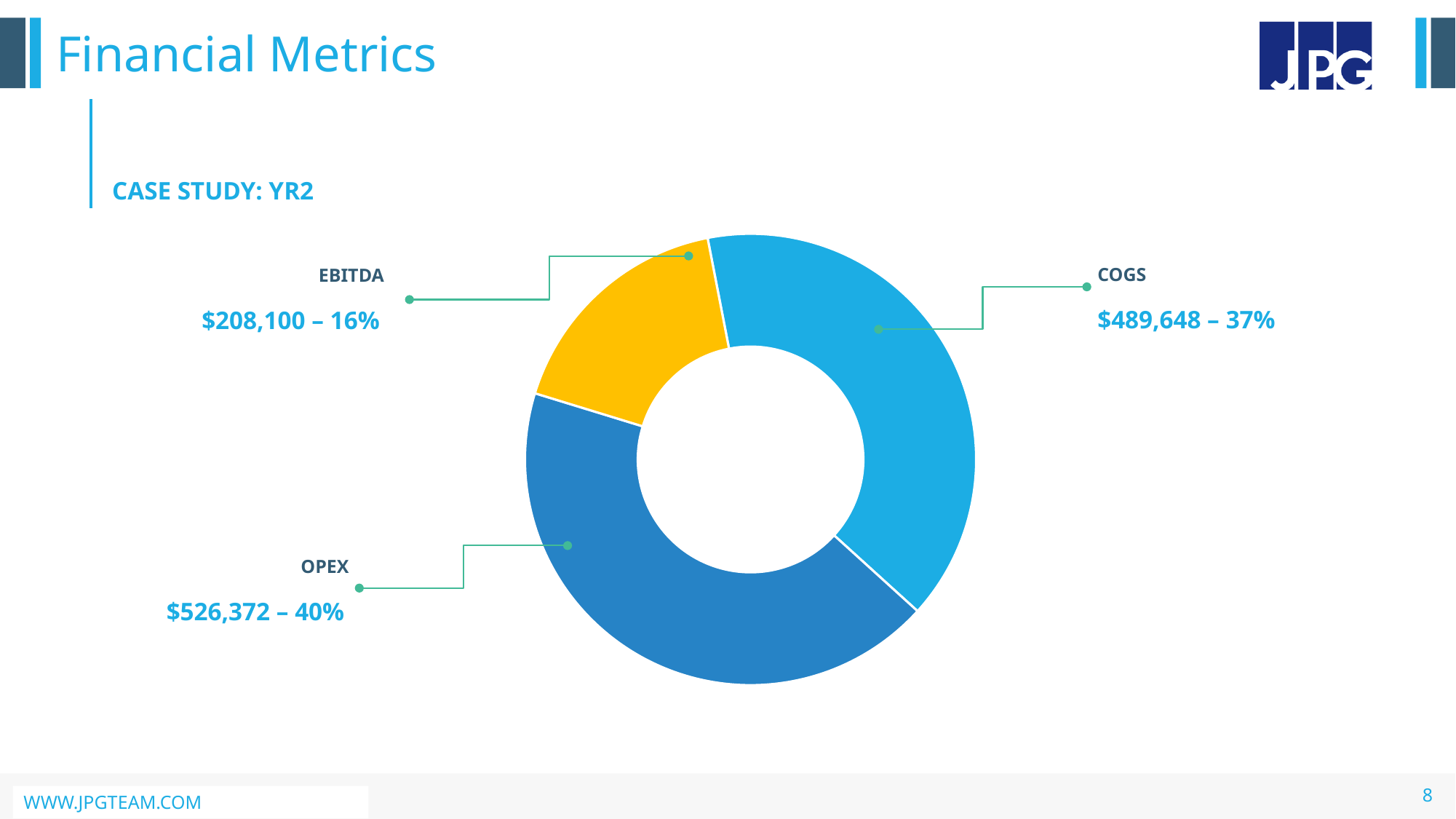
What is the dollar value shown for EBITDA? $208,100 What is the difference in dollars between OPEX and COGS? $36,724 What kind of chart is shown on the slide? Doughnut chart How many categories are shown in the chart? 3 What is the difference in dollars between COGS and EBITDA? $281,548 What percentage share of the chart does COGS represent? 37% Which category has the largest value in the chart? OPEX What is the dollar value shown for OPEX? $526,372 What is the dollar value shown for COGS? $489,648 What percentage share of the chart does EBITDA represent? 16% Which category has the smallest value in the chart? EBITDA Which is larger, the value for COGS or the value for EBITDA? COGS